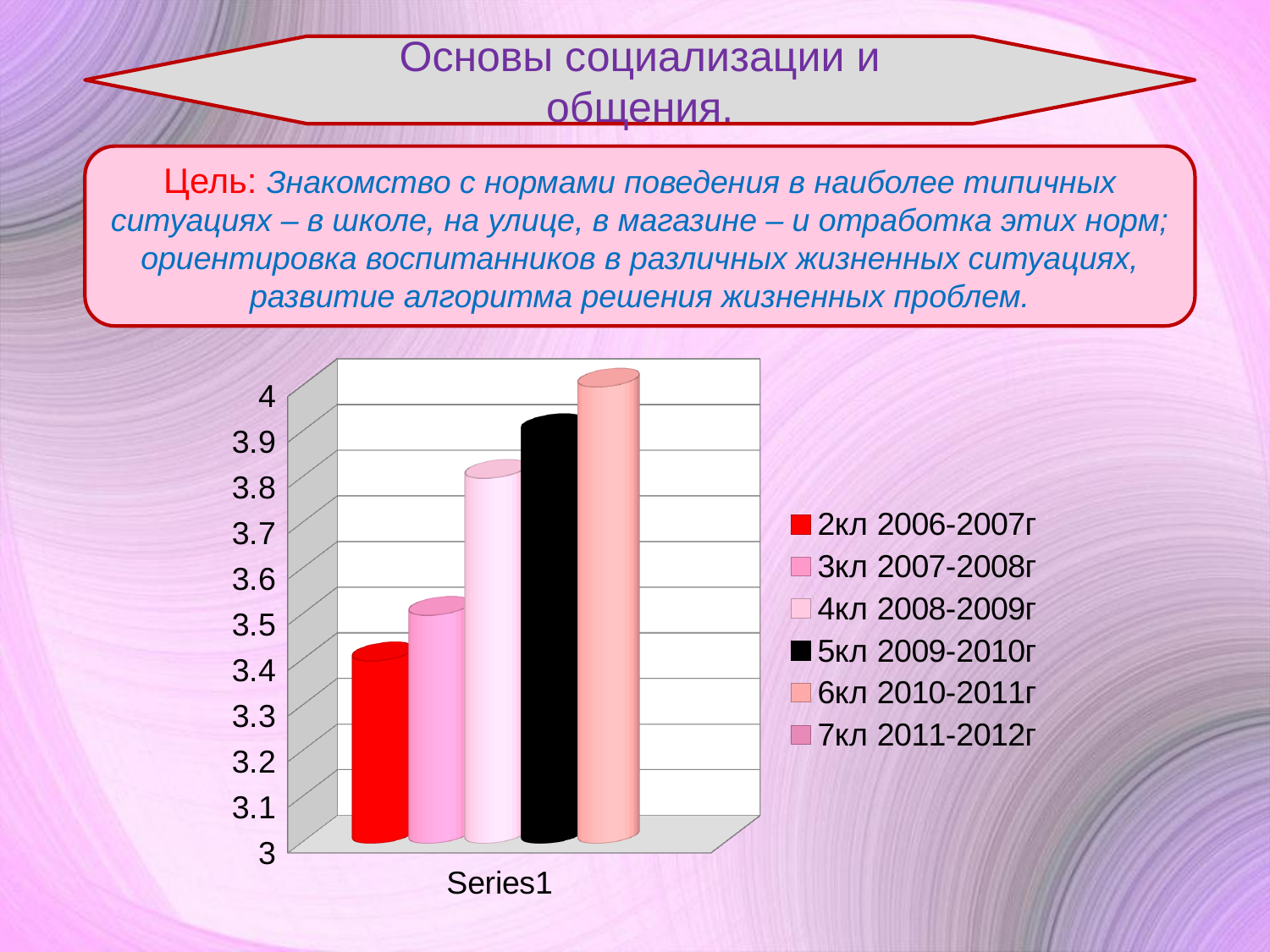
Is the value for 2кл 2006-2007г greater or less than 3.3? greater Is the value for 4кл 2008-2009г greater or less than 3.7? greater Which legend entry has the tallest bar? 6кл 2010-2011г Is the value for 5кл 2009-2010г greater or less than 3.8? greater What label is shown on the horizontal axis of the chart? Series1 Which legend entry has the shortest bar? 2кл 2006-2007г What kind of chart is shown on the slide? bar chart Do the bar heights rise or fall from left to right across the chart? rise Which is larger, the bar for 5кл 2009-2010г or the bar for 3кл 2007-2008г? 5кл 2009-2010г How many bars are plotted in the chart? 5 How many entries does the chart legend list? 6